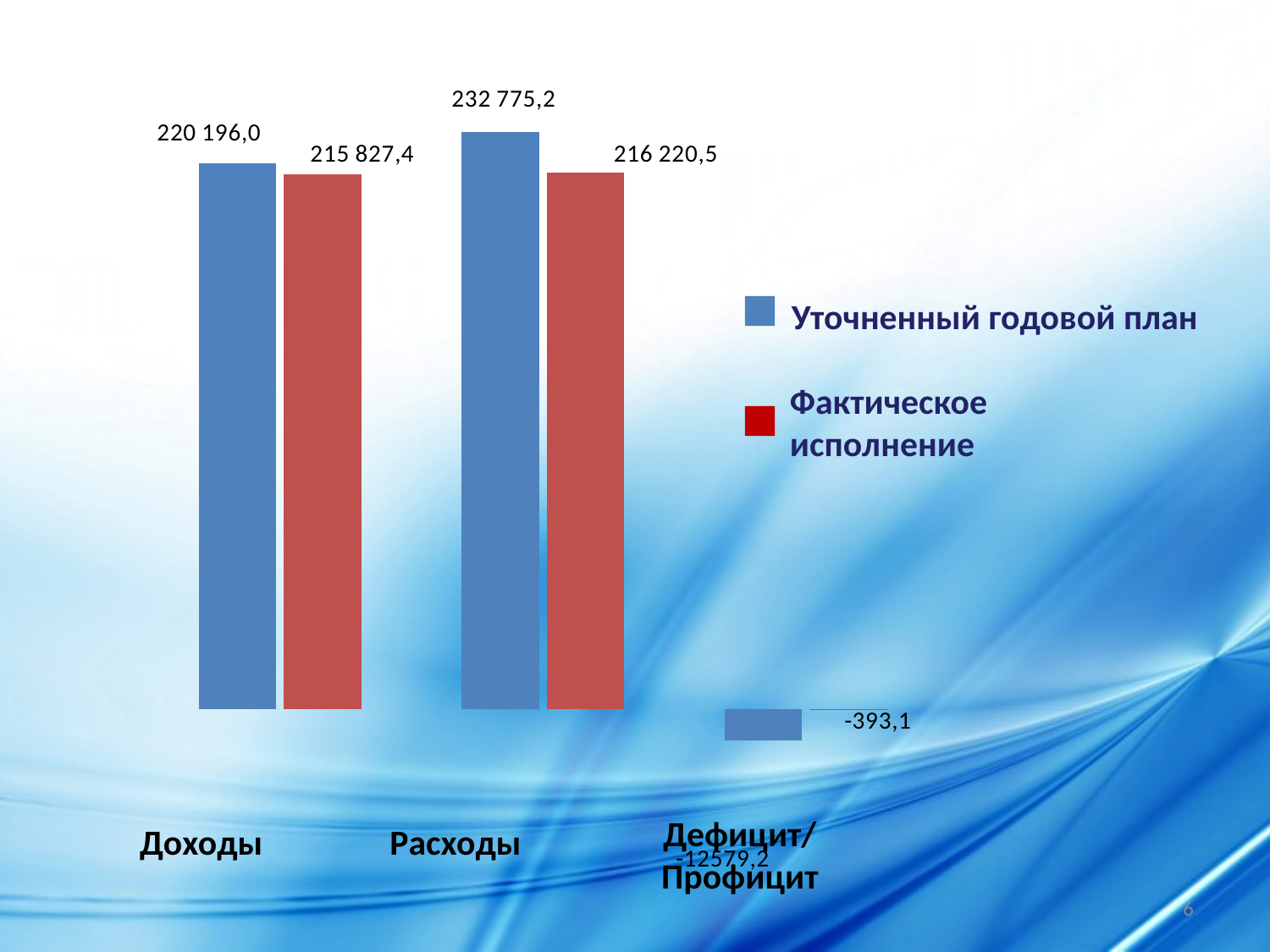
What kind of chart is shown on the slide? Bar chart Which category has the highest value for Уточненный годовой план? Расходы What is the difference between Уточненный годовой план and Фактическое исполнение for Доходы? 4 368,6 Which is larger for Расходы: Уточненный годовой план or Фактическое исполнение? Уточненный годовой план What is the value of Уточненный годовой план for Доходы? 220 196,0 What is the value of Уточненный годовой план for Расходы? 232 775,2 How many series does the legend list? 2 Which category has the lowest value for Фактическое исполнение? Дефицит/Профицит What is the value of Фактическое исполнение for Дефицит/Профицит? -393,1 What is the value of Фактическое исполнение for Расходы? 216 220,5 What is the difference between Уточненный годовой план and Фактическое исполнение for Расходы? 16 554,7 What is the value of Фактическое исполнение for Доходы? 215 827,4